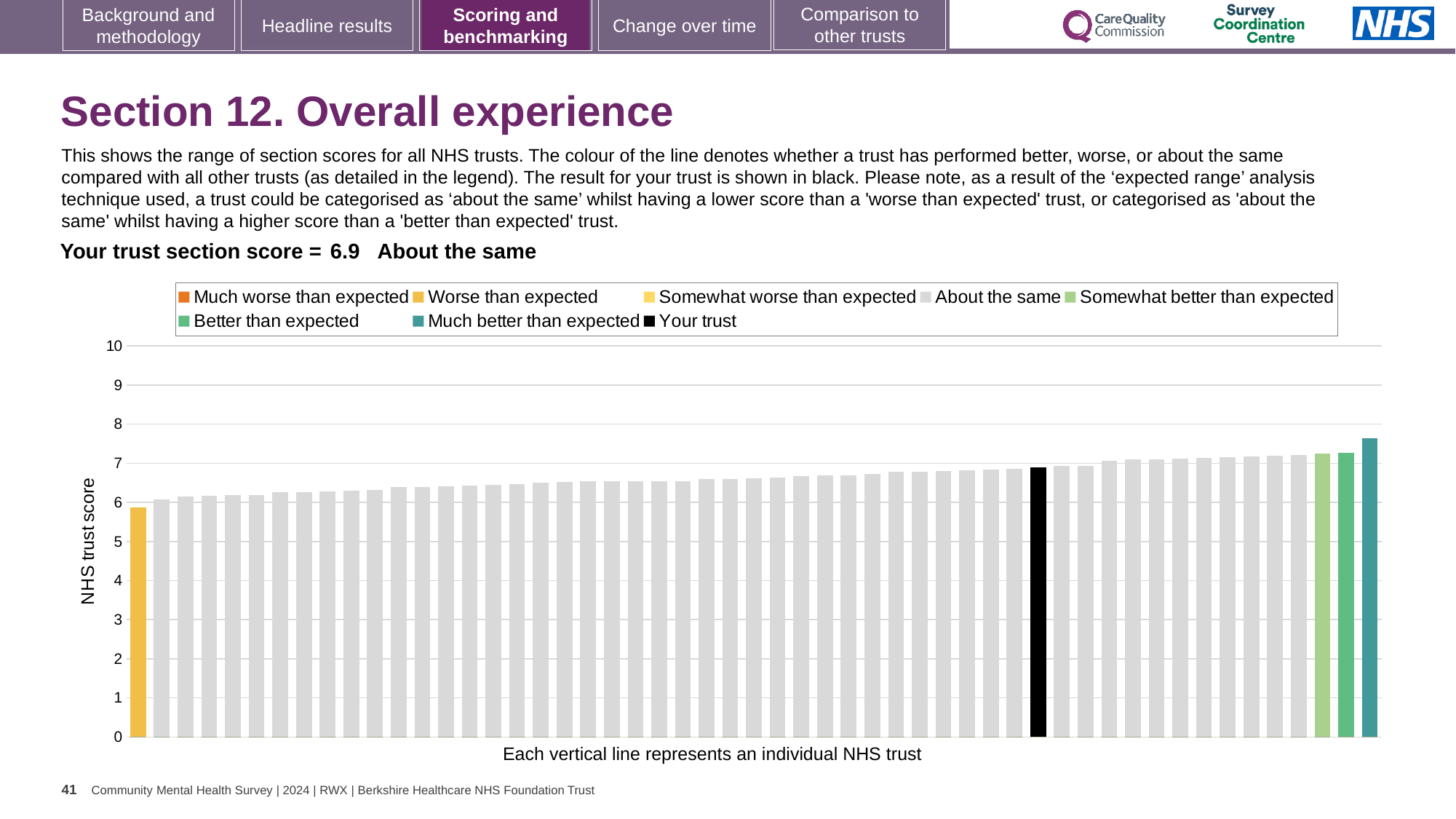
Is the value of the shortest bar (the leftmost, yellow bar) greater or less than 5? greater Is the value of the shortest bar (the leftmost, yellow bar) greater or less than 7? less What kind of chart is shown on the slide? bar chart Which legend category does the colour of the leftmost (lowest) bar correspond to? Worse than expected Is the value of the black bar (your trust) greater or less than 6? greater How many entries does the chart legend list? 8 Do the bar values rise or fall from left to right along the x axis? rise What is the section score for your trust shown on the slide? 6.9 How is your trust categorised compared with other trusts? About the same What is the label on the vertical axis of the chart? NHS trust score